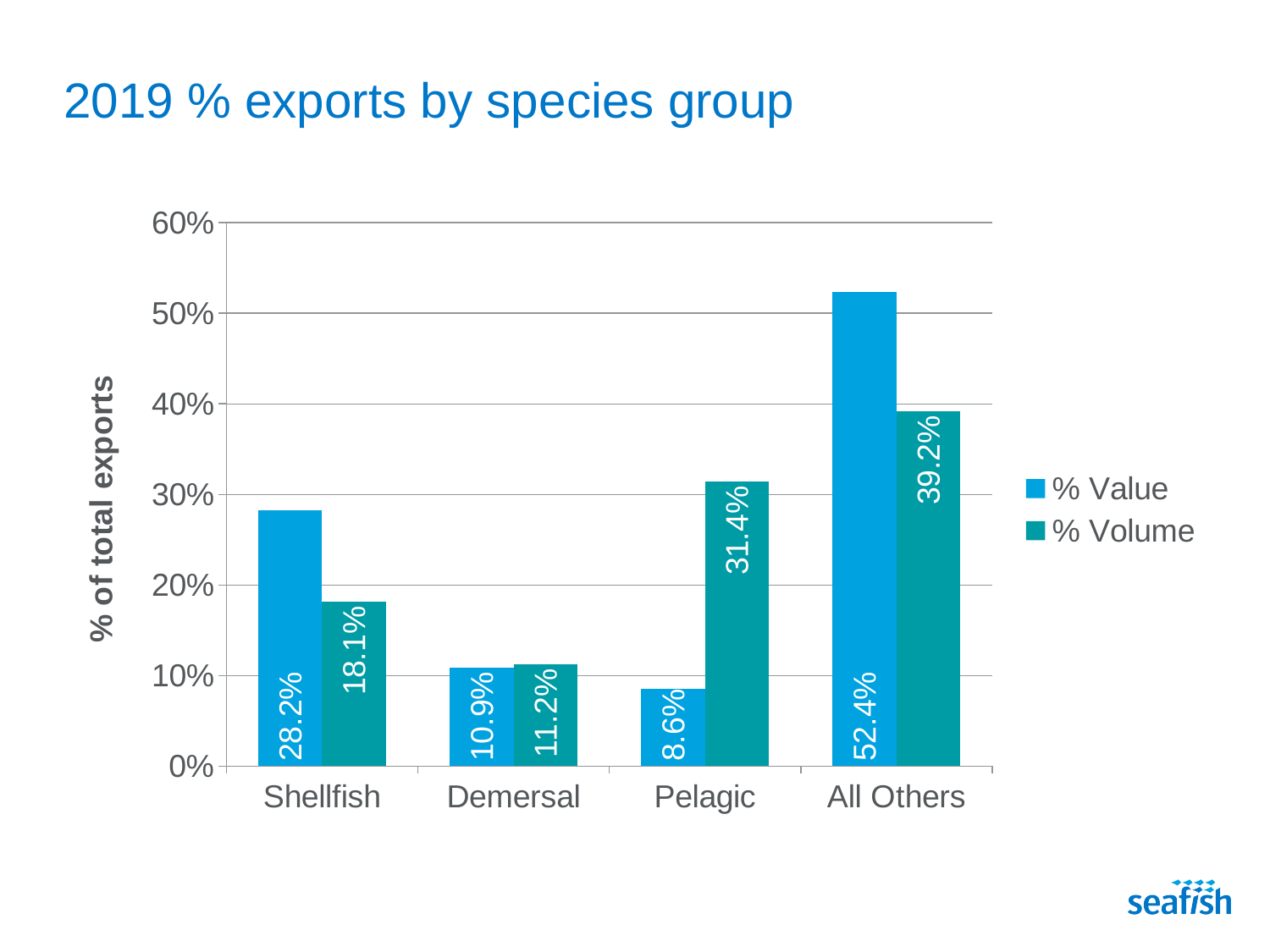
Which is larger for Pelagic, % Value or % Volume? % Volume Is the % Value for Shellfish greater or less than 30%? less What is the difference between % Value and % Volume for All Others? 13.2% What is the % Value for All Others? 52.4% Which species group has the lowest % Value? Pelagic What kind of chart is shown on the slide? Bar chart What is the title of the chart? 2019 % exports by species group What is the % Volume for Pelagic? 31.4% How many series does the legend list? 2 What is the % Value for Shellfish? 28.2% How many species groups are shown on the x axis? 4 Which species group has the highest % Volume? All Others